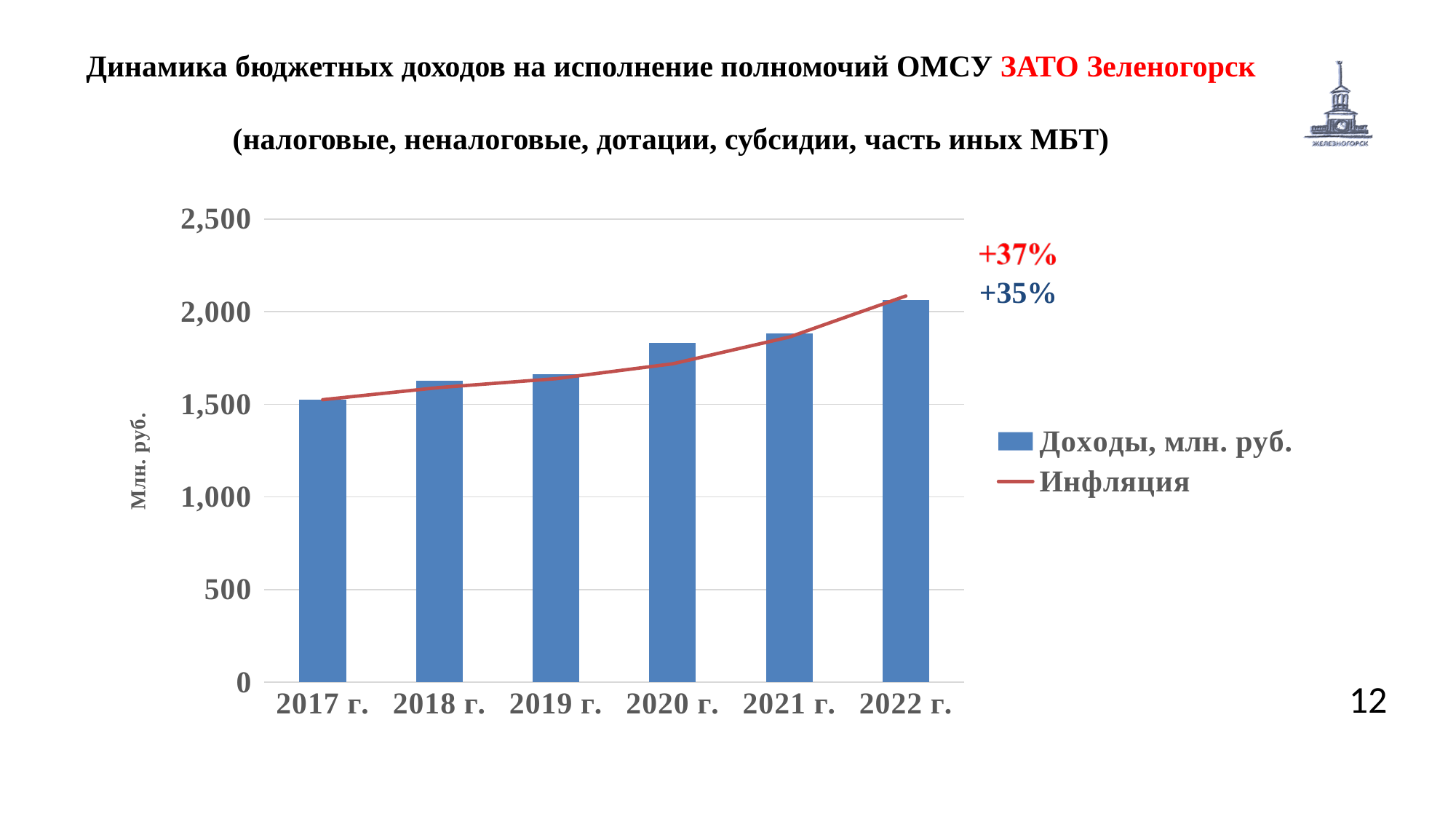
Which series is drawn as a red line in the chart? Инфляция How many series does the chart legend list? 2 Do the Доходы bars rise or fall from 2017 г. to 2022 г.? Rise Is the Доходы value for 2020 г. greater or less than 2,000? less What kind of chart is shown on the slide? Bar chart with a line Which year has the lowest bar for Доходы, млн. руб.? 2017 г. Is the Доходы value for 2018 г. greater or less than 1,500? greater How many years are shown on the x axis of the chart? 6 What is the label of the y axis of the chart? Млн. руб. Which year has the highest bar for Доходы, млн. руб.? 2022 г. Which year has the larger Доходы bar, 2019 г. or 2021 г.? 2021 г. Is the Доходы value for 2022 г. greater or less than 2,000? greater